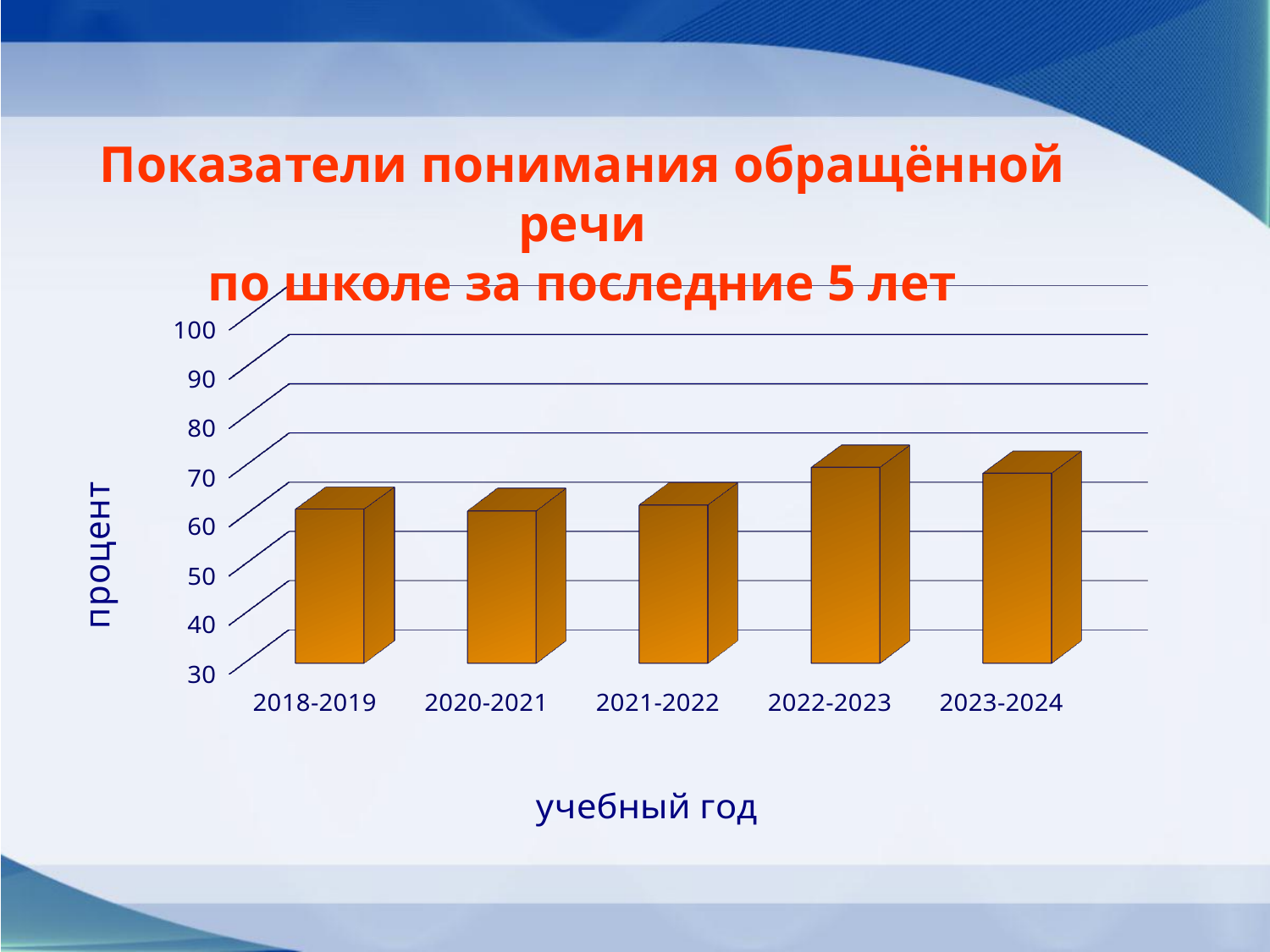
What is the label of the horizontal axis? учебный год Is the value for 2023-2024 greater or less than 80? less Which academic year has the highest bar? 2022-2023 How many academic years (categories) are shown on the x axis? 5 Which is larger, the value for 2022-2023 or the value for 2018-2019? 2022-2023 Which is larger, the value for 2023-2024 or the value for 2020-2021? 2023-2024 Is the value for 2022-2023 greater or less than 60? greater What kind of chart is shown on the slide? bar chart Is the value for 2018-2019 greater or less than 50? greater What is the label of the vertical axis? процент